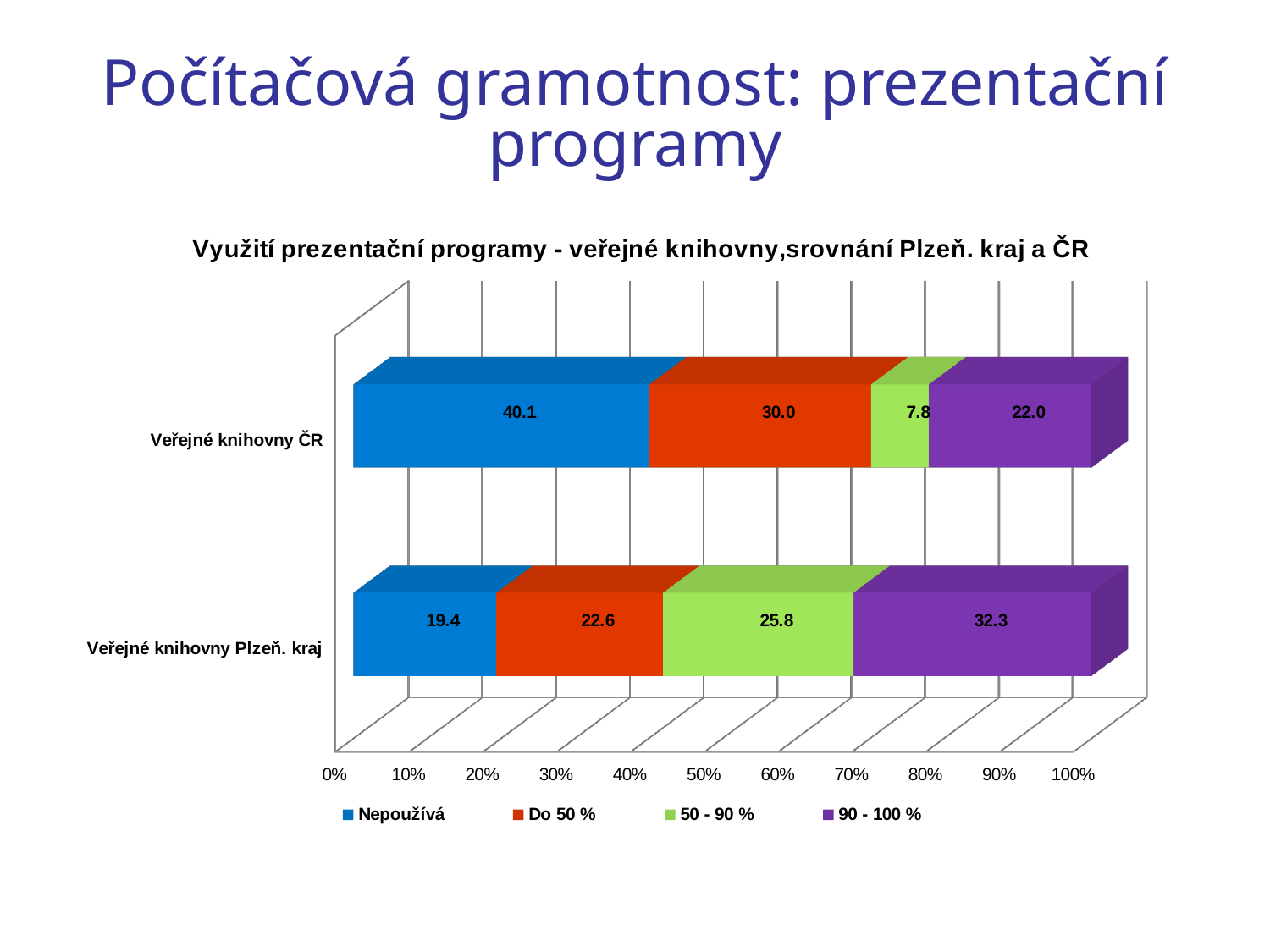
How many categories (bars) are shown in the chart? 2 Which segment is the largest in the Veřejné knihovny ČR bar? Nepoužívá How many series does the legend list? 4 What is the value of the 'Do 50 %' segment for Veřejné knihovny Plzeň. kraj? 22.6 What is the value of the '90 - 100 %' segment for Veřejné knihovny Plzeň. kraj? 32.3 What is the difference between the 'Nepoužívá' values for Veřejné knihovny ČR and Veřejné knihovny Plzeň. kraj? 20.7 Which has a larger '50 - 90 %' value, Veřejné knihovny ČR or Veřejné knihovny Plzeň. kraj? Veřejné knihovny Plzeň. kraj What is the value of the 'Nepoužívá' segment for Veřejné knihovny ČR? 40.1 Which segment is the smallest in the Veřejné knihovny Plzeň. kraj bar? Nepoužívá What is the total of the stacked bar for Veřejné knihovny ČR? 99.9 What kind of chart is shown on the slide? Stacked bar chart What is the value of the '50 - 90 %' segment for Veřejné knihovny ČR? 7.8